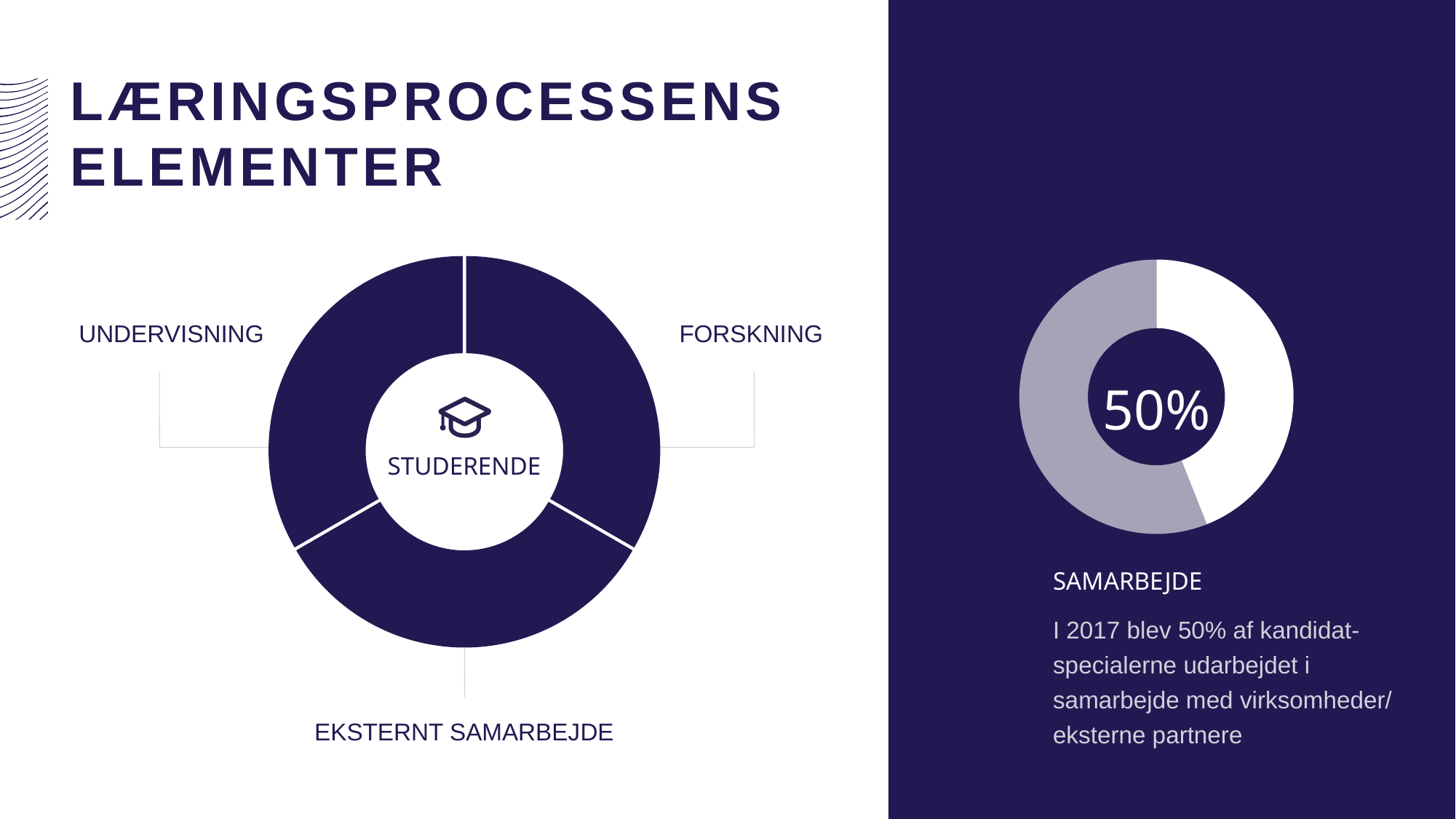
Which year does the text under the SAMARBEJDE donut chart on the right side of the slide refer to? 2017 What kind of chart is the chart on the left side of the slide? donut (pie) chart How many segments does the SAMARBEJDE donut chart on the right side of the slide have? 2 In the SAMARBEJDE donut chart on the right side of the slide, is the value shown greater or less than 40%? greater What kind of chart is the chart on the right side of the slide, labelled SAMARBEJDE? donut (pie) chart What value is printed in the centre of the SAMARBEJDE donut chart on the right side of the slide? 50% Which label is shown below the donut chart on the left side of the slide? EKSTERNT SAMARBEJDE What text is shown in the centre of the donut chart on the left side of the slide? STUDERENDE How many segments does the donut chart on the left side of the slide have? 3